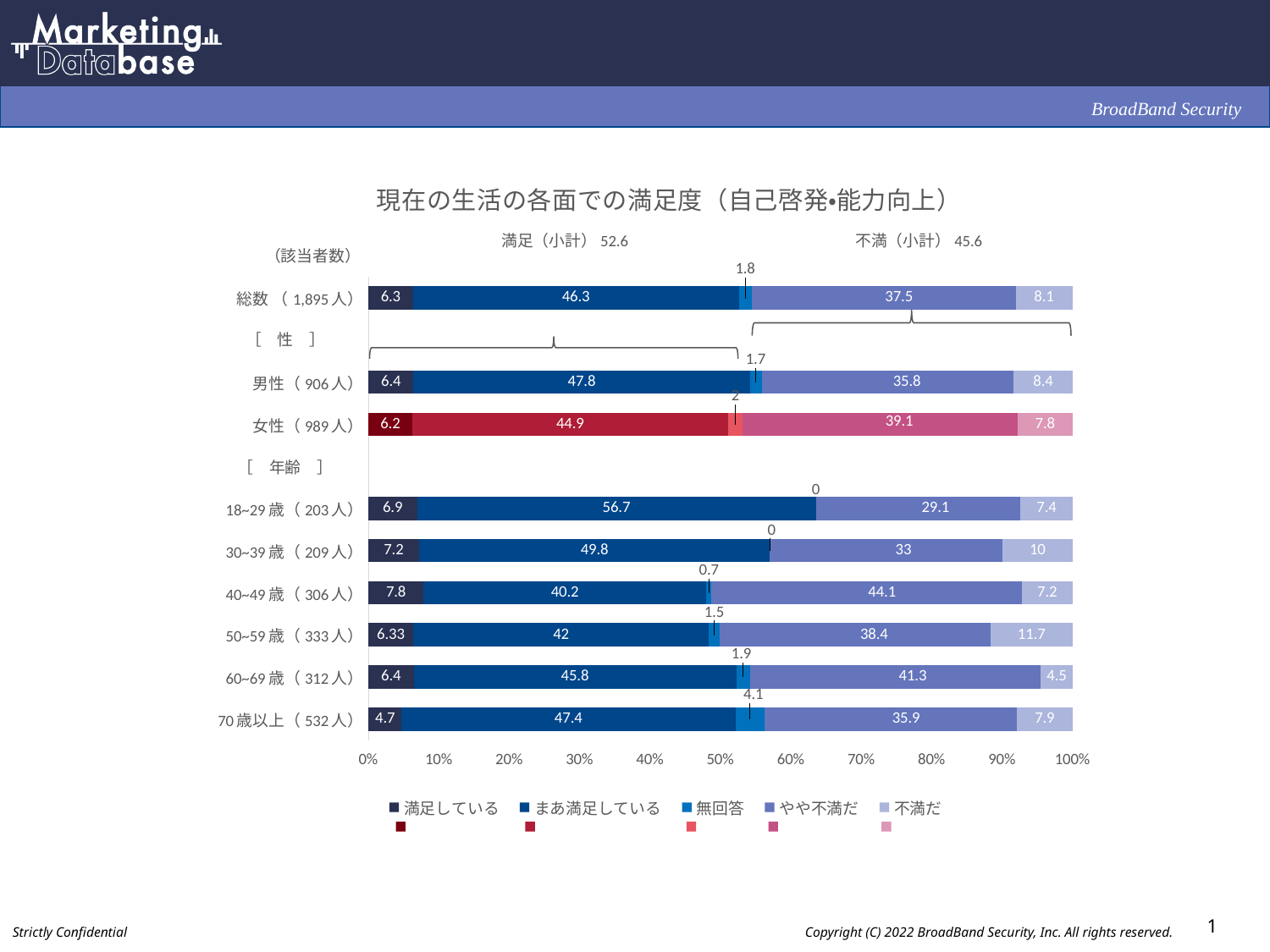
What is the difference between the まあ満足している values for 男性 (906人) and 女性 (989人)? 2.9 Which category has the highest value for まあ満足している? 18~29歳 (203人) How many series are listed in the legend? 5 What is the value of 無回答 for 70歳以上 (532人)? 4.1 What type of chart is shown on the slide? Stacked bar chart Which is larger, the やや不満だ value for 40~49歳 (306人) or for 18~29歳 (203人)? 40~49歳 (306人) What is the 満足（小計） value shown above the chart? 52.6 What is the value of 不満だ for 50~59歳 (333人)? 11.7 How many categories (bars) are plotted in the chart? 9 Which category has the lowest value for 満足している? 70歳以上 (532人) Which category has the lowest value for 不満だ? 60~69歳 (312人) What is the value of まあ満足している for 総数 (1,895人)? 46.3